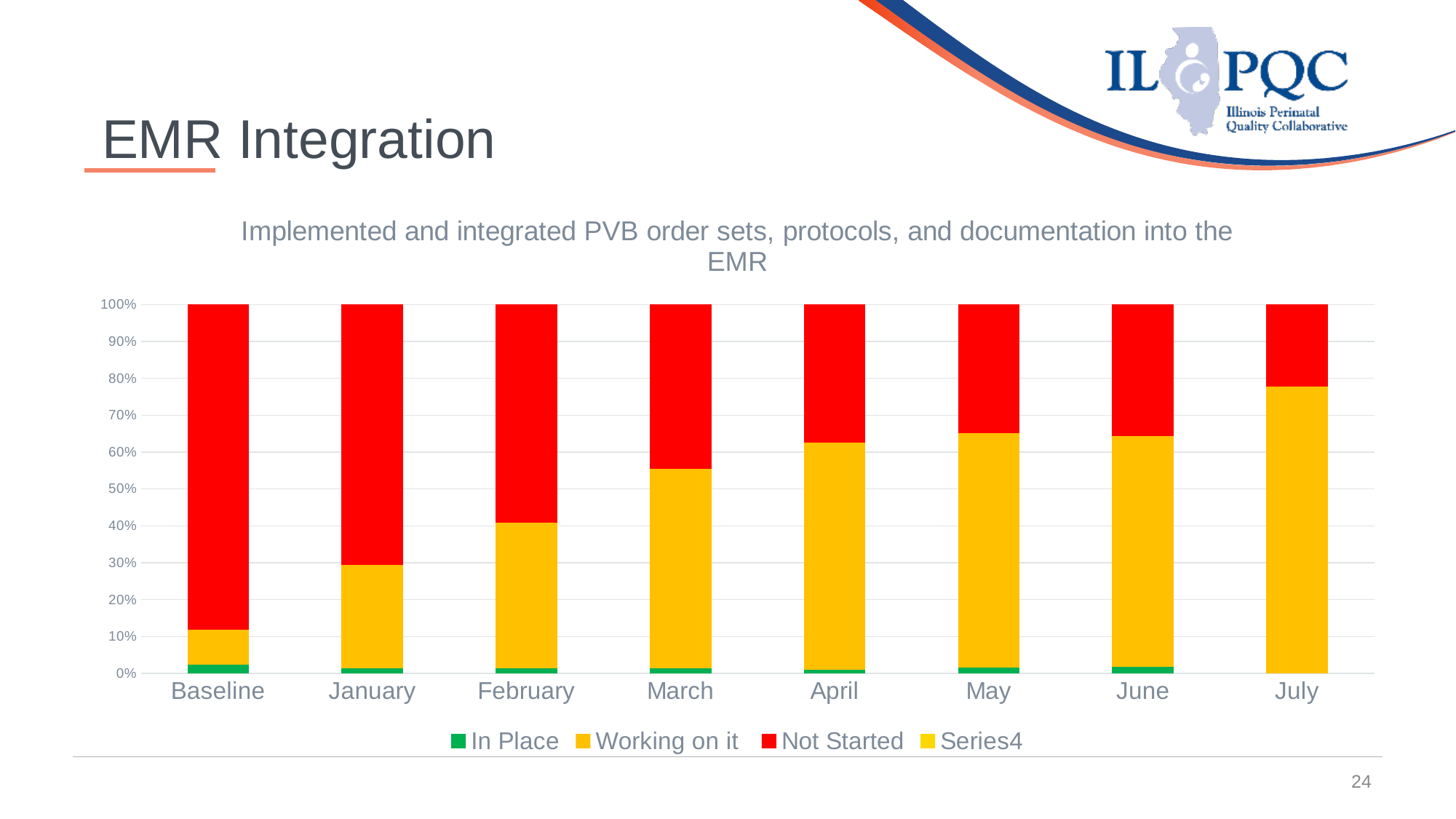
Is the Not Started value for Baseline greater or less than 80%? greater How many series does the chart's legend list? 4 Is the Working on it value for July greater or less than 70%? greater Which is larger, the Not Started segment for Baseline or for July? Baseline What kind of chart is shown on the slide? Stacked bar chart Does the Working on it share generally rise or fall from Baseline to July? Rise Which category has the largest Working on it segment? July Which category has the smallest Working on it segment? Baseline What colour represents the Not Started series in the chart? Red How many categories are shown along the x axis of the chart? 8 Is the Not Started value for July greater or less than 30%? less Which category has the largest Not Started segment? Baseline